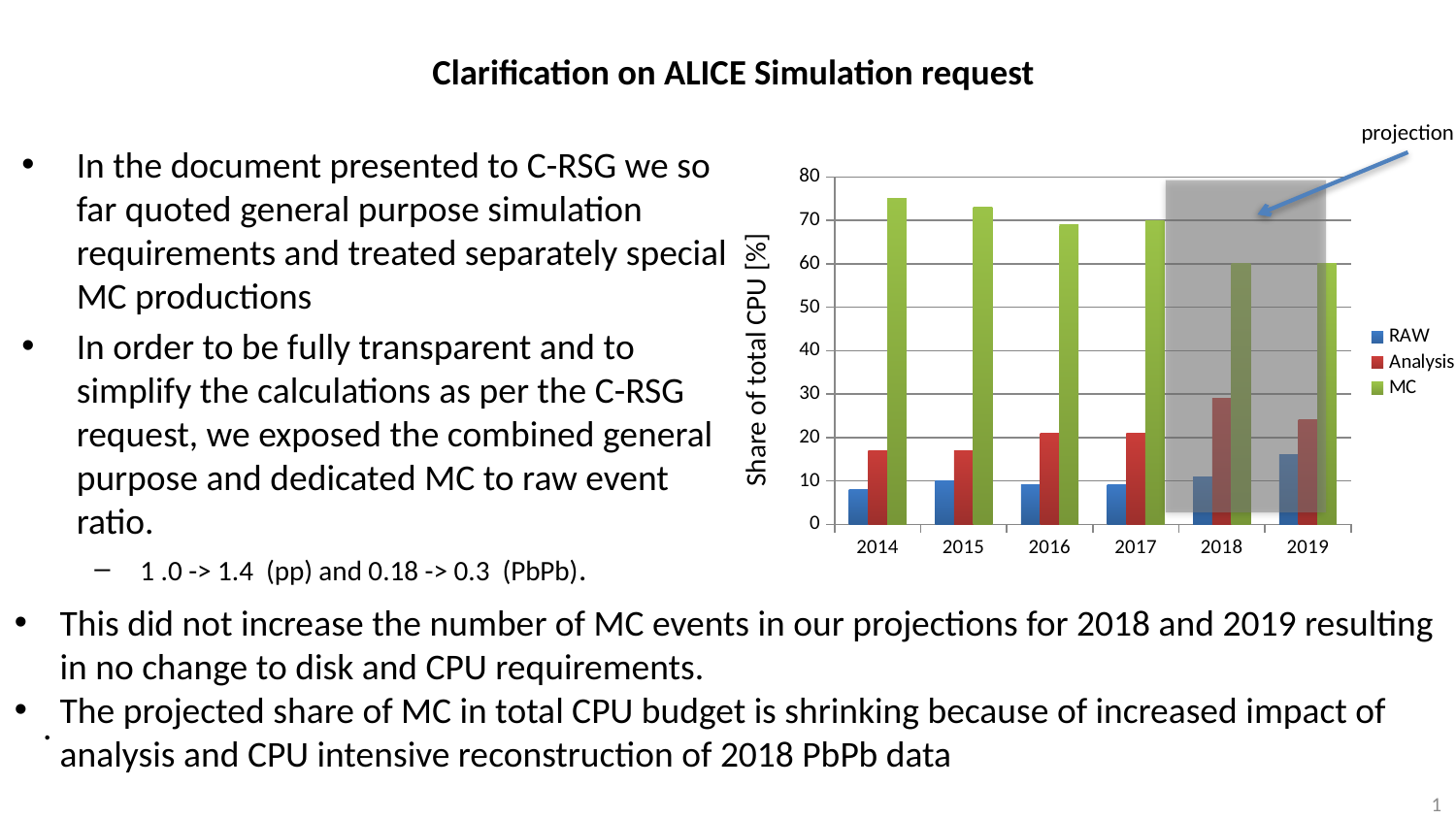
In which year is the MC share of total CPU highest? 2014 Is the Analysis value for 2018 greater or less than 20? greater In which year is the RAW share of total CPU highest? 2019 What is the label of the y axis of the chart? Share of total CPU [%] How many years are shown on the x axis of the chart? 6 Which is larger, the Analysis value for 2018 or the Analysis value for 2019? 2018 What kind of chart is shown on the slide? bar chart Is the MC value for 2014 greater or less than 70? greater How many series does the chart legend list? 3 In which year is the Analysis share of total CPU highest? 2018 Does the MC share of total CPU rise or fall from 2014 to 2019? fall Is the RAW value for 2014 greater or less than 10? less